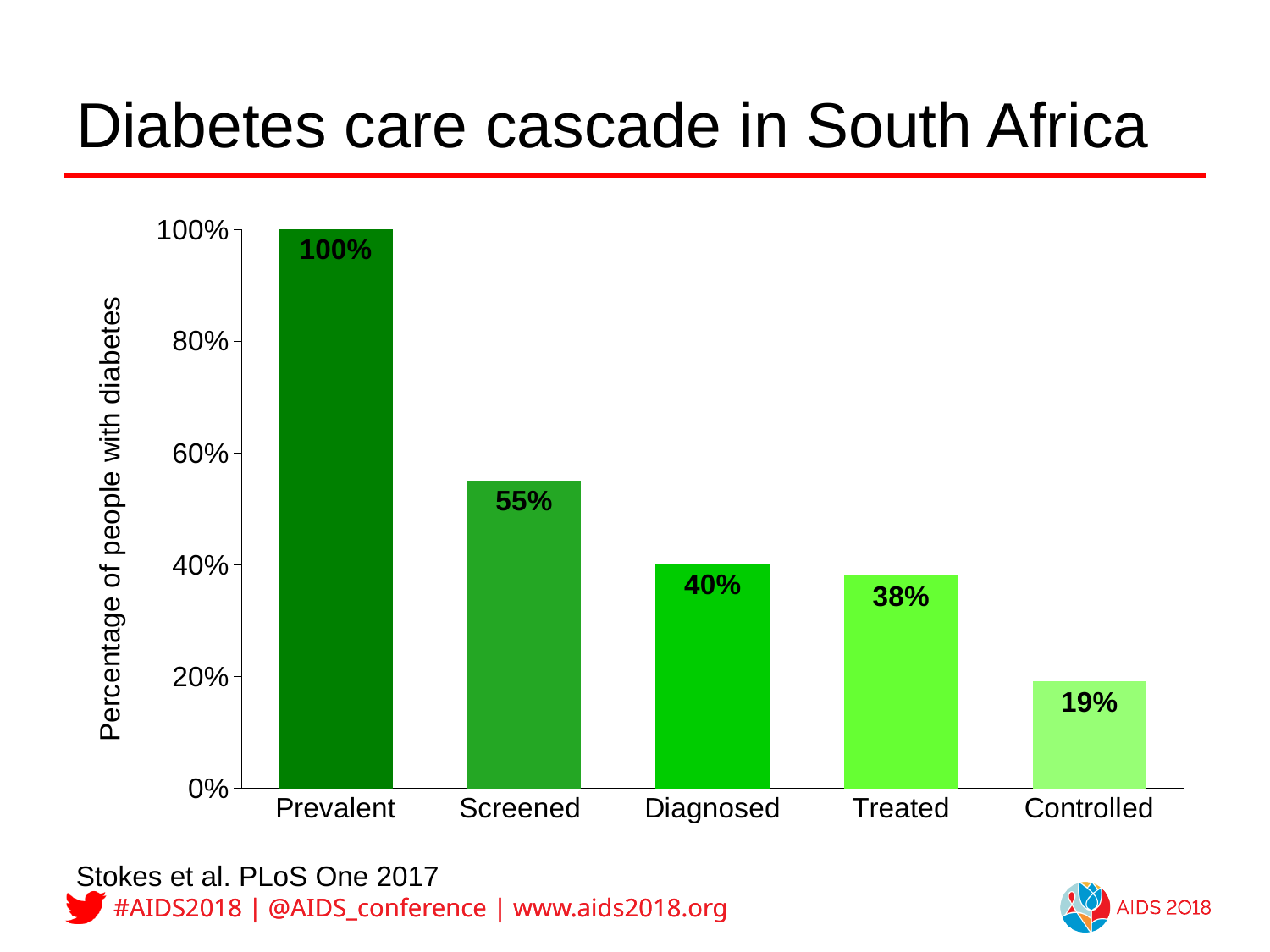
Which is larger, the value for Diagnosed or the value for Controlled? Diagnosed What is the value for Controlled? 19% What kind of chart is shown on the slide? Bar chart Which category has the lowest value? Controlled How many categories are shown on the x axis? 5 What is the label of the y axis? Percentage of people with diabetes What is the value for Treated? 38% What is the value for Screened? 55% Which category has the highest value? Prevalent Do the values rise or fall from left to right along the x axis? Fall What is the difference between the values for Prevalent and Controlled? 81% What is the difference between the values for Screened and Diagnosed? 15%